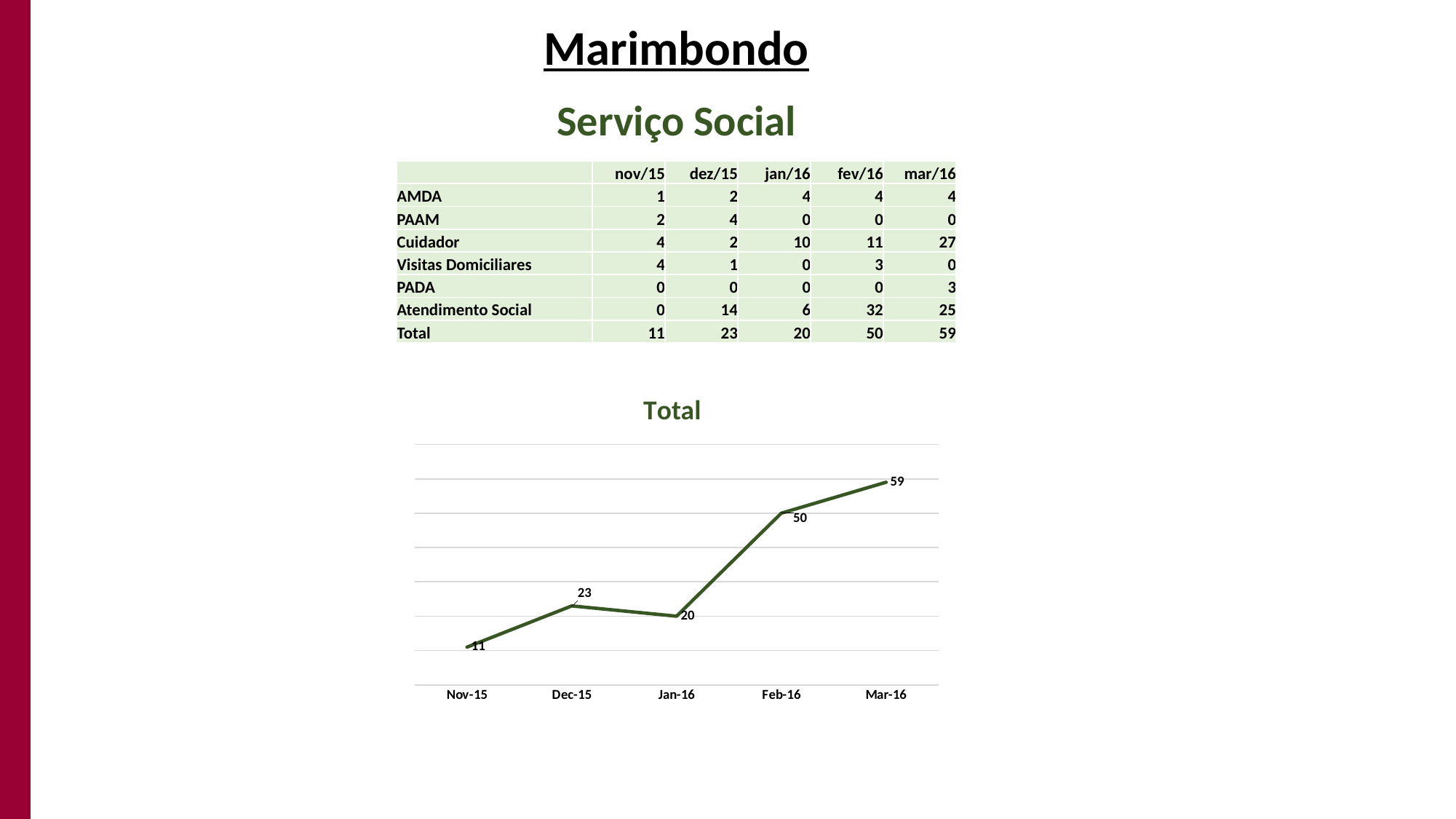
What is the difference between the Dec-15 and Jan-16 values in the Total chart? 3 Do the values in the Total chart generally rise or fall from Nov-15 to Mar-16? rise What is the difference between the Mar-16 and Feb-16 values in the Total chart? 9 What is the value for Jan-16 in the Total chart? 20 Which month has the lowest value in the Total chart? Nov-15 What kind of chart is the Total chart? line chart Which month has the highest value in the Total chart? Mar-16 How many data points are plotted in the Total chart? 5 What is the value for Nov-15 in the Total chart? 11 What is the title of the chart on the slide? Total What is the value for Feb-16 in the Total chart? 50 Which is larger in the Total chart, the value for Dec-15 or the value for Jan-16? Dec-15